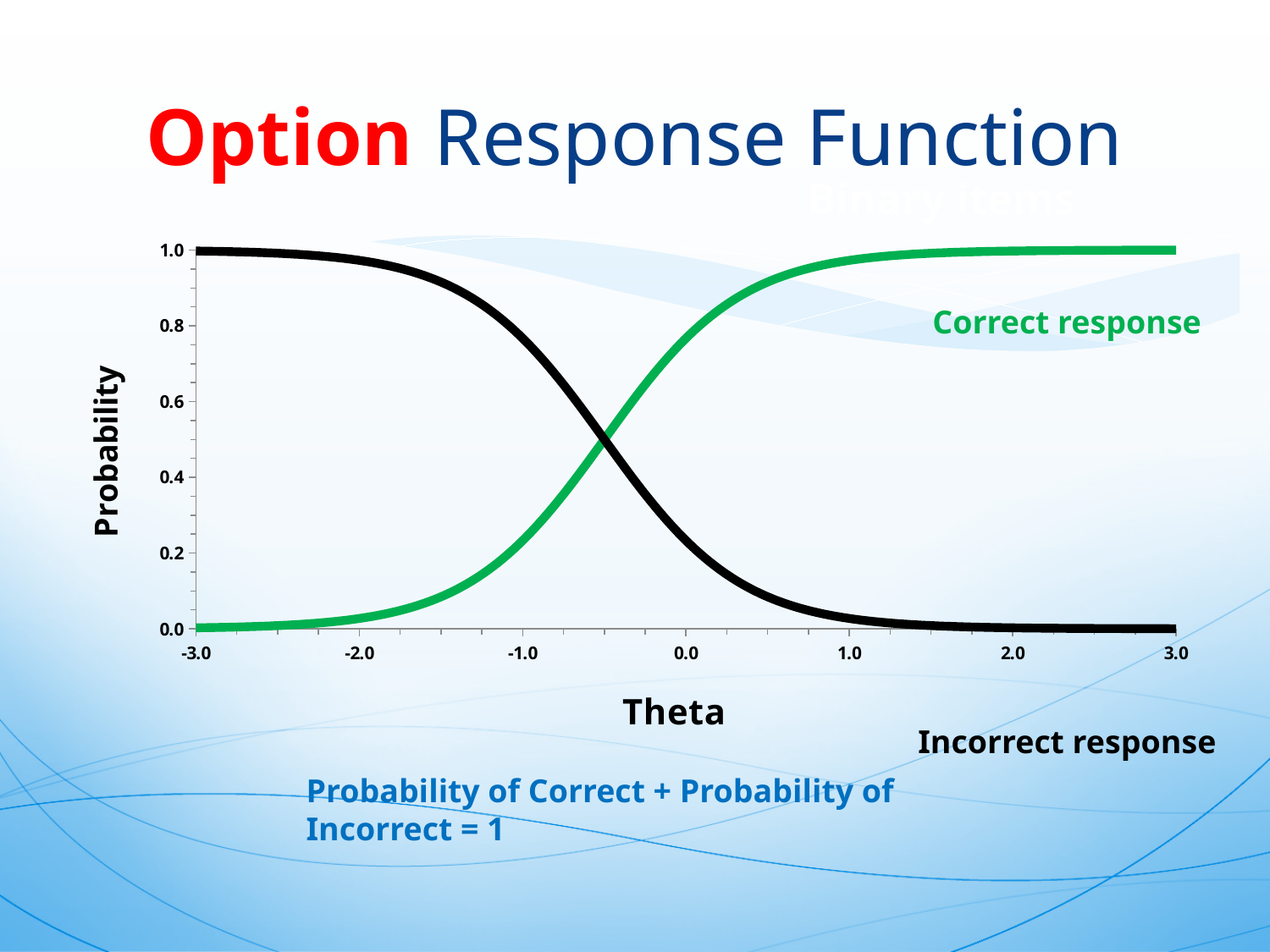
How many series (curves) are plotted on the chart? 2 Is the probability of a Correct response at Theta = -2.0 greater or less than 0.2? less What kind of chart is shown on the slide? line chart Does the Incorrect response curve rise or fall as Theta increases from -3.0 to 3.0? fall Does the Correct response curve rise or fall as Theta increases from -3.0 to 3.0? rise Is the probability of an Incorrect response at Theta = -2.0 greater or less than 0.8? greater Is the probability of an Incorrect response at Theta = 1.0 greater or less than 0.2? less At Theta = 2.0, which curve has the higher probability, Correct response or Incorrect response? Correct response At Theta = -2.0, which curve has the higher probability, Correct response or Incorrect response? Incorrect response What is the label of the x axis? Theta What colour is the Correct response curve? green